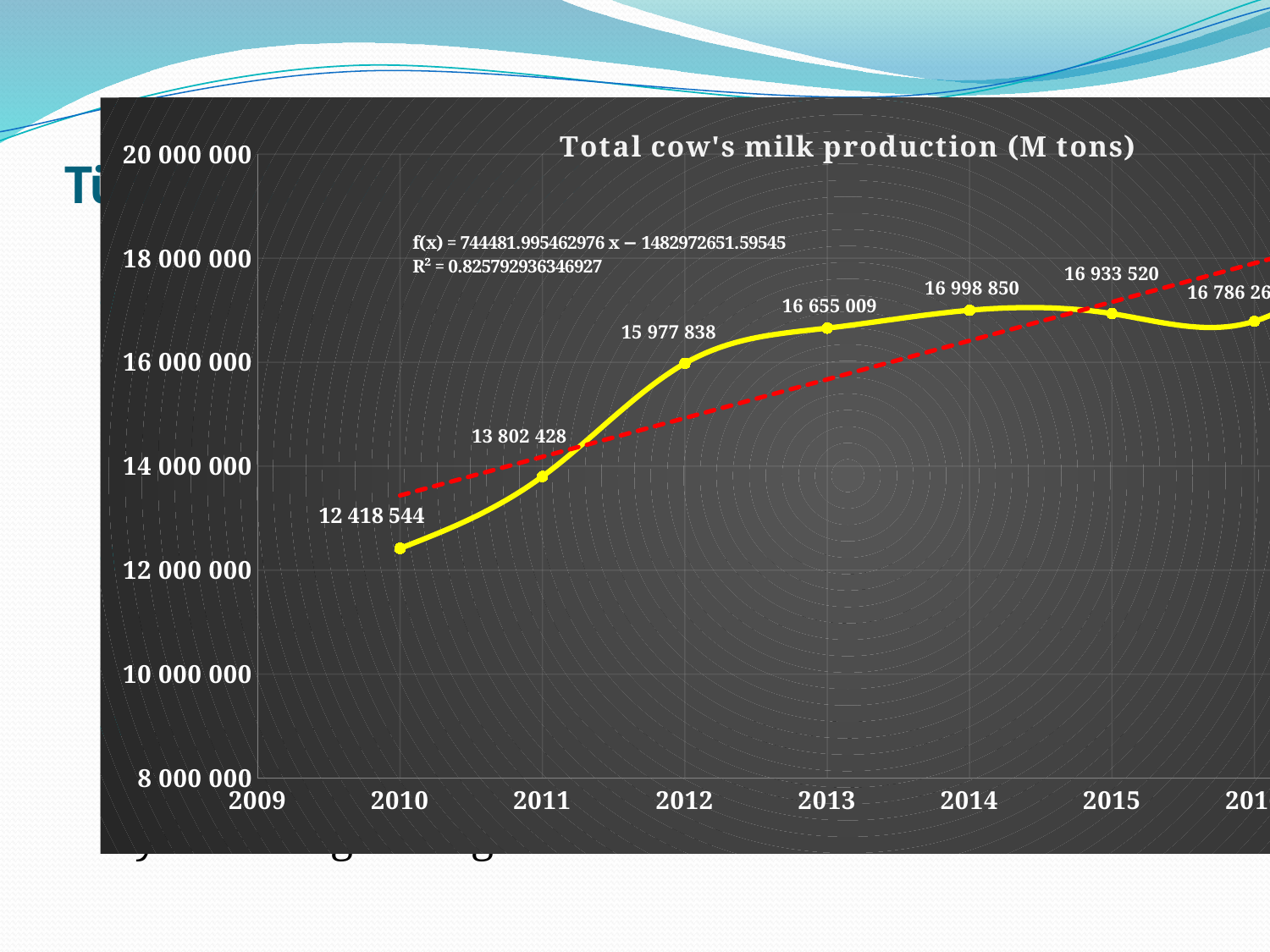
Did total cow's milk production rise or fall from 2010 to 2014? rise What kind of chart is shown on the slide? line chart Is the value for 2010 greater or less than 14 000 000? less What was the total cow's milk production in 2014? 16 998 850 What was the total cow's milk production in 2015? 16 933 520 What was the total cow's milk production in 2012? 15 977 838 Which year had higher total cow's milk production, 2014 or 2015? 2014 What was the total cow's milk production in 2010? 12 418 544 Which year from 2010 to 2015 had the highest total cow's milk production? 2014 What R² value is shown for the trendline on the chart? 0.825792936346927 By how much did total cow's milk production increase from 2010 to 2011? 1 383 884 Which year shown had the lowest total cow's milk production? 2010